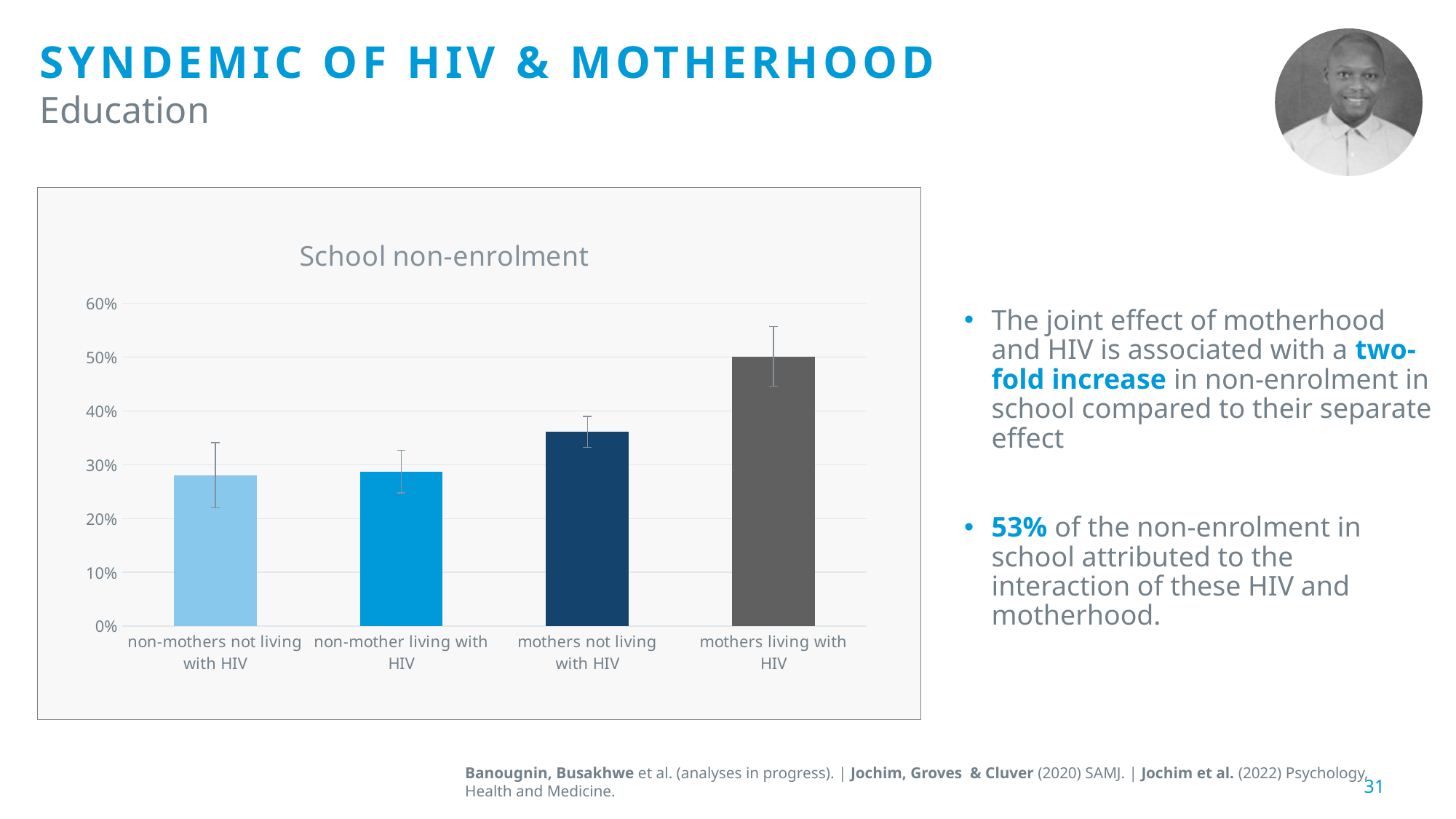
How many categories are shown on the x axis of the chart? 4 Is the value for mothers living with HIV greater or less than 60%? less Is the value for mothers living with HIV greater or less than 40%? greater What kind of chart is shown on the slide? bar chart What is the title of the chart? School non-enrolment What is the highest value shown on the y axis of the chart? 60% Is the value for non-mothers not living with HIV greater or less than 20%? greater Which is larger: the value for mothers not living with HIV or the value for non-mothers not living with HIV? mothers not living with HIV Which category has the highest school non-enrolment? mothers living with HIV Do the bar values rise or fall from left to right across the categories? rise Which is larger: the value for mothers living with HIV or the value for mothers not living with HIV? mothers living with HIV